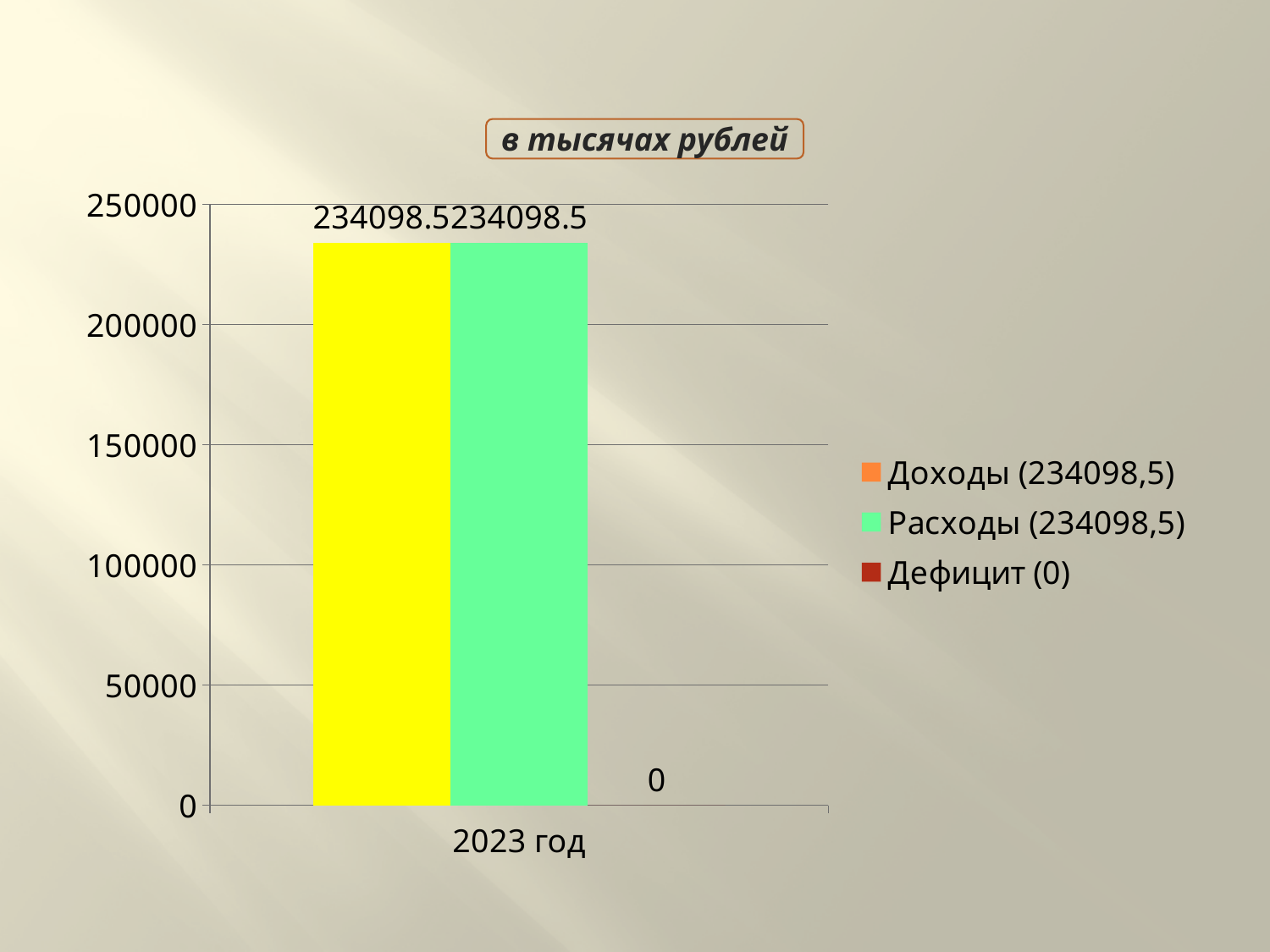
Which series has the lowest value for 2023 год? Дефицит What is the value of Расходы for 2023 год? 234098.5 Is the value for Доходы in 2023 год greater or less than 200000? greater What kind of chart is shown on the slide? bar chart What is the difference between Доходы and Расходы for 2023 год? 0 What is the value of Дефицит for 2023 год? 0 What is the title of the chart? в тысячах рублей How many series does the legend list? 3 What category label is shown on the x axis? 2023 год How many categories are shown on the x axis? 1 What is the value of Доходы for 2023 год? 234098.5 Is the value for Расходы in 2023 год greater or less than 250000? less